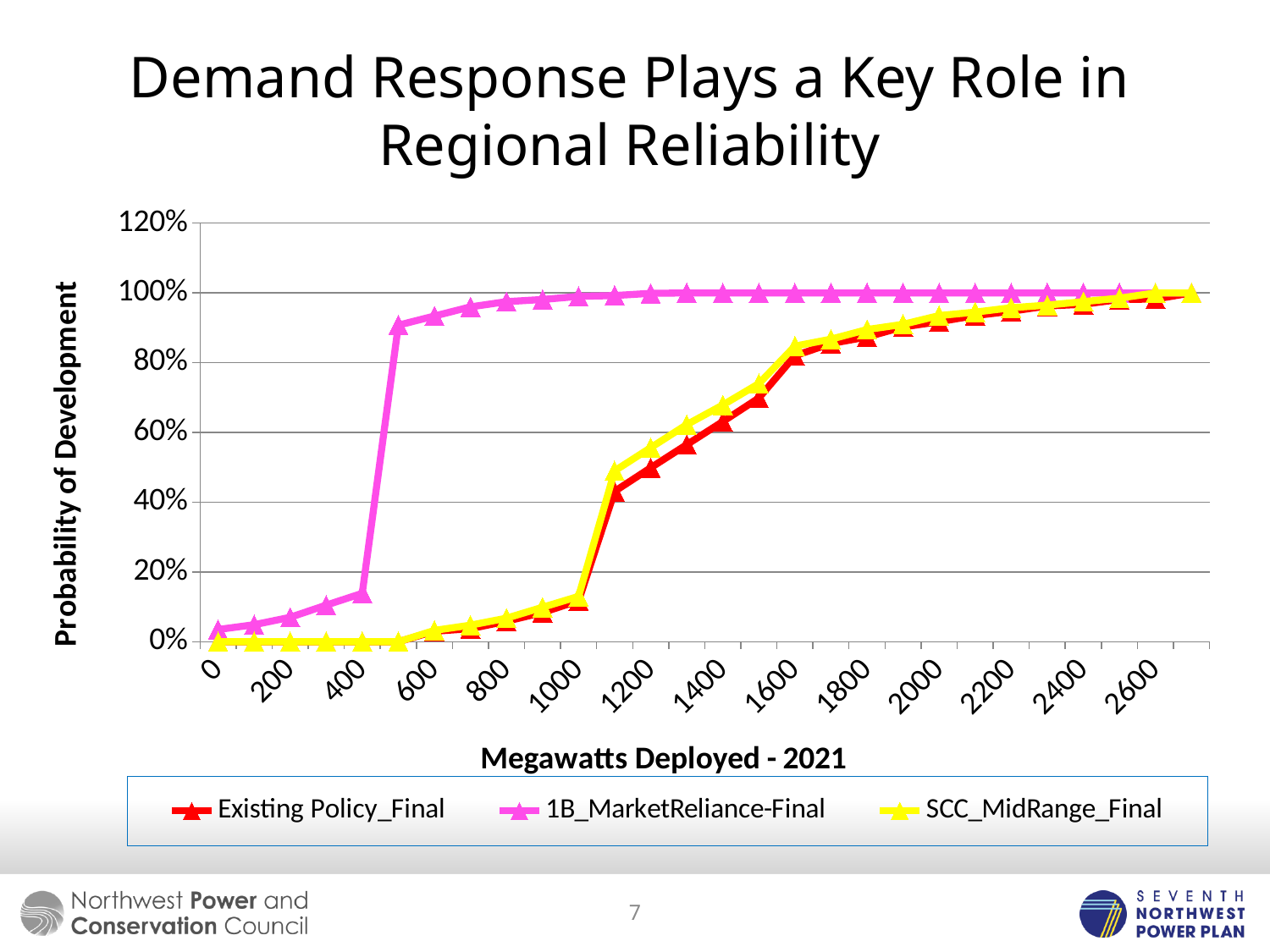
What kind of chart is shown on the slide? line chart How many series does the chart legend list? 3 Is the value for 1B_MarketReliance-Final at 400 megawatts greater or less than 20%? less What is the title of the chart's y axis? Probability of Development What is the title of the chart's x axis? Megawatts Deployed - 2021 Is the value for Existing Policy_Final at 400 megawatts greater or less than 20%? less Do the values for Existing Policy_Final rise or fall as megawatts deployed increases? rise Is the value for 1B_MarketReliance-Final at 600 megawatts greater or less than 80%? greater At 600 megawatts, which series has the higher probability of development: 1B_MarketReliance-Final or Existing Policy_Final? 1B_MarketReliance-Final At 1200 megawatts, which series has the higher probability of development: SCC_MidRange_Final or Existing Policy_Final? SCC_MidRange_Final